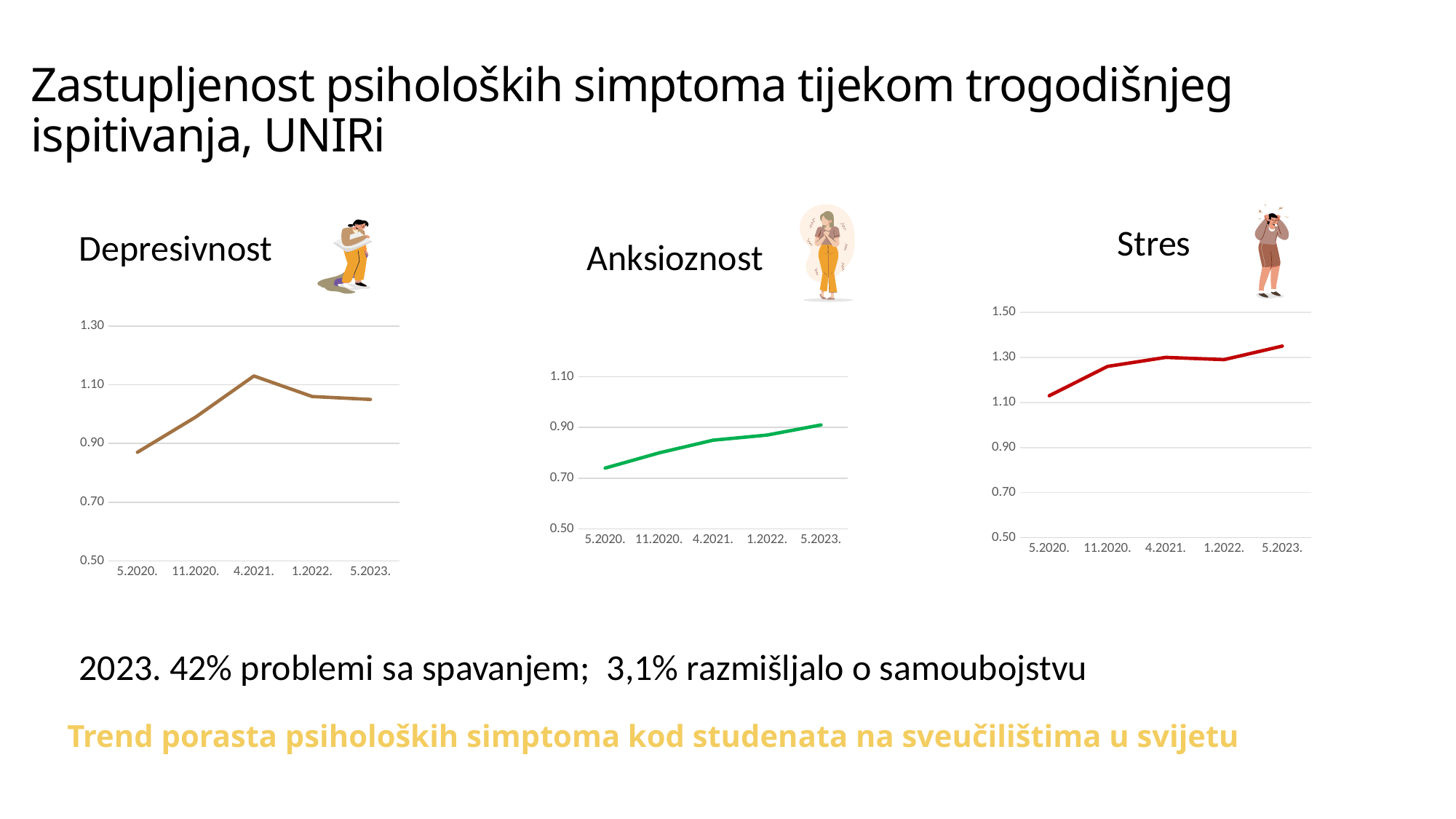
How many time points are plotted on the Anksioznost chart? 5 On the Depresivnost chart, is the value for 4.2021. greater or less than 1.10? greater On the Depresivnost chart, is the value for 5.2020. greater or less than 0.90? less On the Stres chart, at which time point is the value highest? 5.2023. On the Stres chart, is the value for 11.2020. greater or less than 1.30? less On the Depresivnost chart, at which time point is the value lowest? 5.2020. On the Depresivnost chart, at which time point is the value highest? 4.2021. What kind of chart is the Depresivnost chart? line chart On the Anksioznost chart, do the values rise or fall from 5.2020. to 5.2023.? rise On the Anksioznost chart, at which time point is the value lowest? 5.2020. On the Stres chart, which is larger, the value for 5.2020. or the value for 4.2021.? 4.2021.